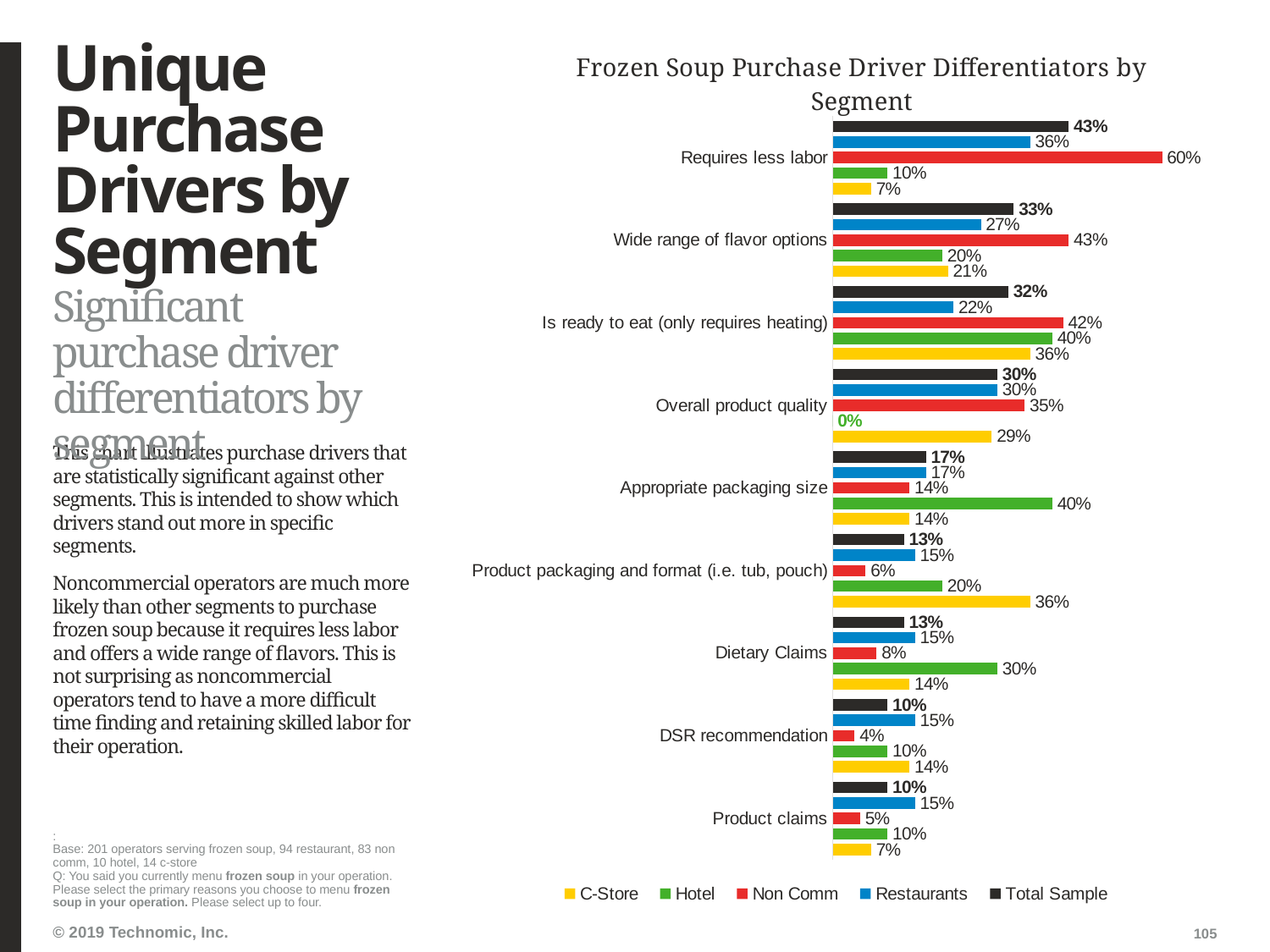
What is the Hotel value for Appropriate packaging size? 40% Which category has the lowest Non Comm value? DSR recommendation Which category has the highest Total Sample value? Requires less labor Which colour represents Non Comm in the legend? Red What is the difference between the Non Comm and C-Store values for Requires less labor? 53% What is the Hotel value for Overall product quality? 0% What is the Non Comm value for Requires less labor? 60% How many categories are shown on the chart? 9 How many series does the legend list? 5 What is the C-Store value for Product packaging and format (i.e. tub, pouch)? 36% For Dietary Claims, which is larger: the Hotel value or the Restaurants value? Hotel What kind of chart is shown on the slide? Bar chart